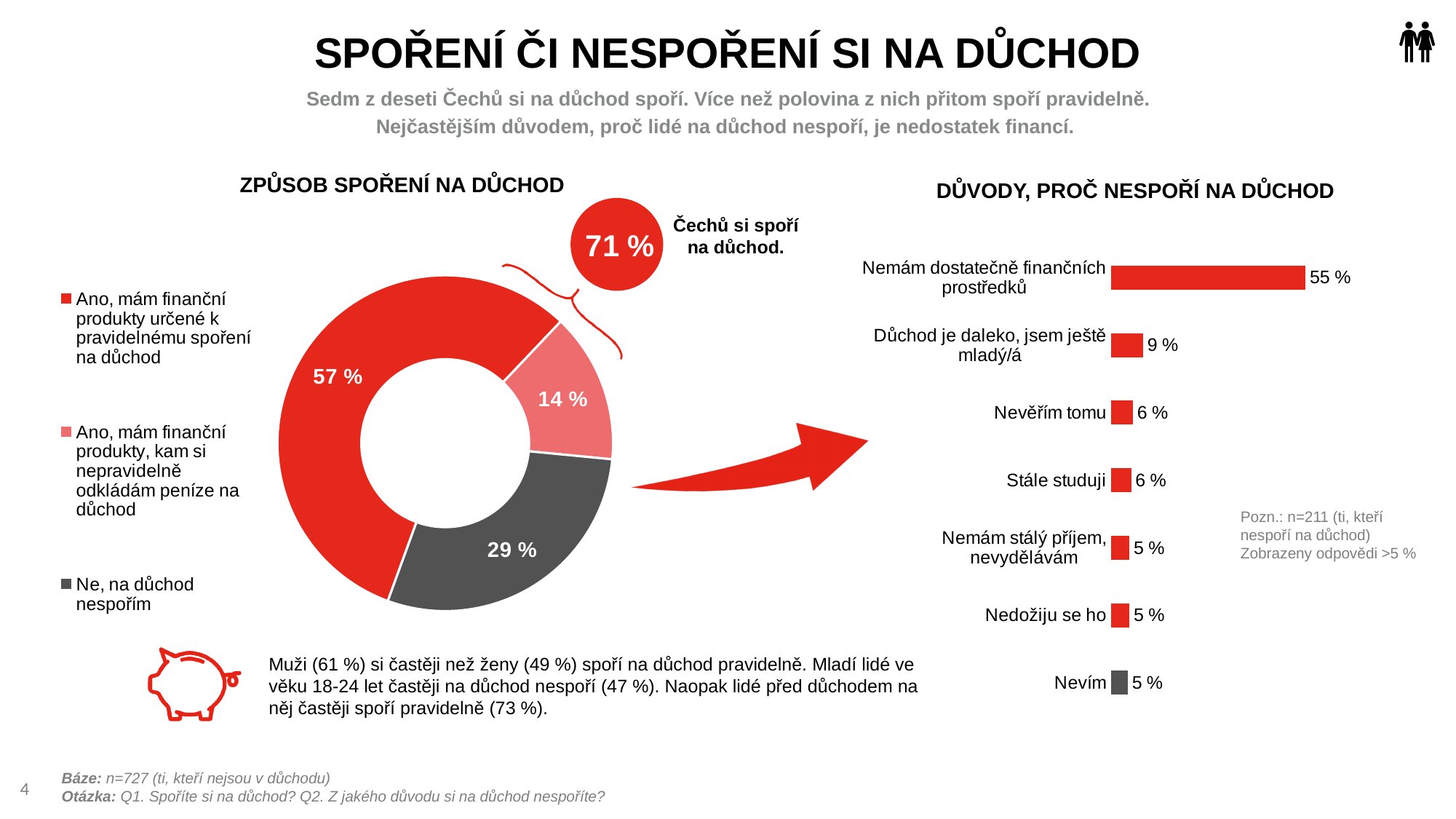
How many categories does the legend of the chart 'ZPŮSOB SPOŘENÍ NA DŮCHOD' list? 3 What type of chart is 'DŮVODY, PROČ NESPOŘÍ NA DŮCHOD'? Bar chart In the chart 'DŮVODY, PROČ NESPOŘÍ NA DŮCHOD', which reason has the highest value? Nemám dostatečně finančních prostředků In the chart 'ZPŮSOB SPOŘENÍ NA DŮCHOD', what share of respondents answered 'Ne, na důchod nespořím'? 29 % What type of chart is 'ZPŮSOB SPOŘENÍ NA DŮCHOD'? Donut (pie) chart In the chart 'ZPŮSOB SPOŘENÍ NA DŮCHOD', what is the difference between the share saving regularly (57 %) and the share not saving (29 %)? 28 % In the chart 'DŮVODY, PROČ NESPOŘÍ NA DŮCHOD', what is the value for 'Nevěřím tomu'? 6 % In the chart 'ZPŮSOB SPOŘENÍ NA DŮCHOD', what share of respondents have financial products for regular retirement saving ('Ano, mám finanční produkty určené k pravidelnému spoření na důchod')? 57 % In the chart 'ZPŮSOB SPOŘENÍ NA DŮCHOD', what share of respondents save irregularly ('Ano, mám finanční produkty, kam si nepravidelně odkládám peníze na důchod')? 14 % How many reasons are shown in the chart 'DŮVODY, PROČ NESPOŘÍ NA DŮCHOD'? 7 In the chart 'DŮVODY, PROČ NESPOŘÍ NA DŮCHOD', what is the difference between 'Nemám dostatečně finančních prostředků' and 'Důchod je daleko, jsem ještě mladý/á'? 46 % In the chart 'DŮVODY, PROČ NESPOŘÍ NA DŮCHOD', what is the value for 'Důchod je daleko, jsem ještě mladý/á'? 9 %